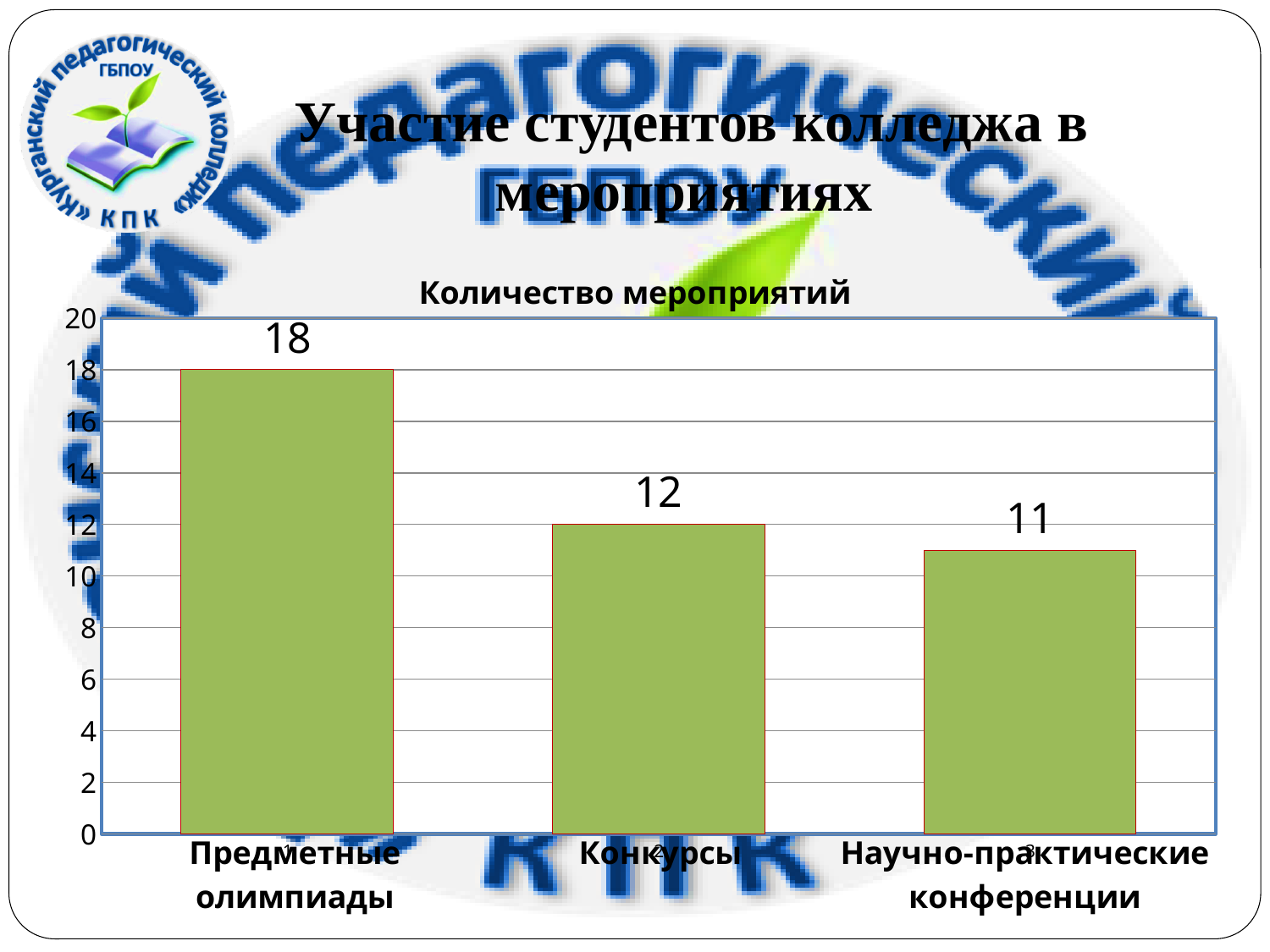
What is the title of the chart? Количество мероприятий Which category has the highest value? Предметные олимпиады What kind of chart is shown on the slide? bar chart Which is larger, the value for Предметные олимпиады or the value for Научно-практические конференции? Предметные олимпиады Which category has the lowest value? Научно-практические конференции What is the difference between the values for Предметные олимпиады and Конкурсы? 6 What is the value for Конкурсы? 12 What is the value for Предметные олимпиады? 18 How many categories are shown in the chart? 3 What is the difference between the values for Конкурсы and Научно-практические конференции? 1 Is the value for Конкурсы greater or less than 10? greater What is the value for Научно-практические конференции? 11